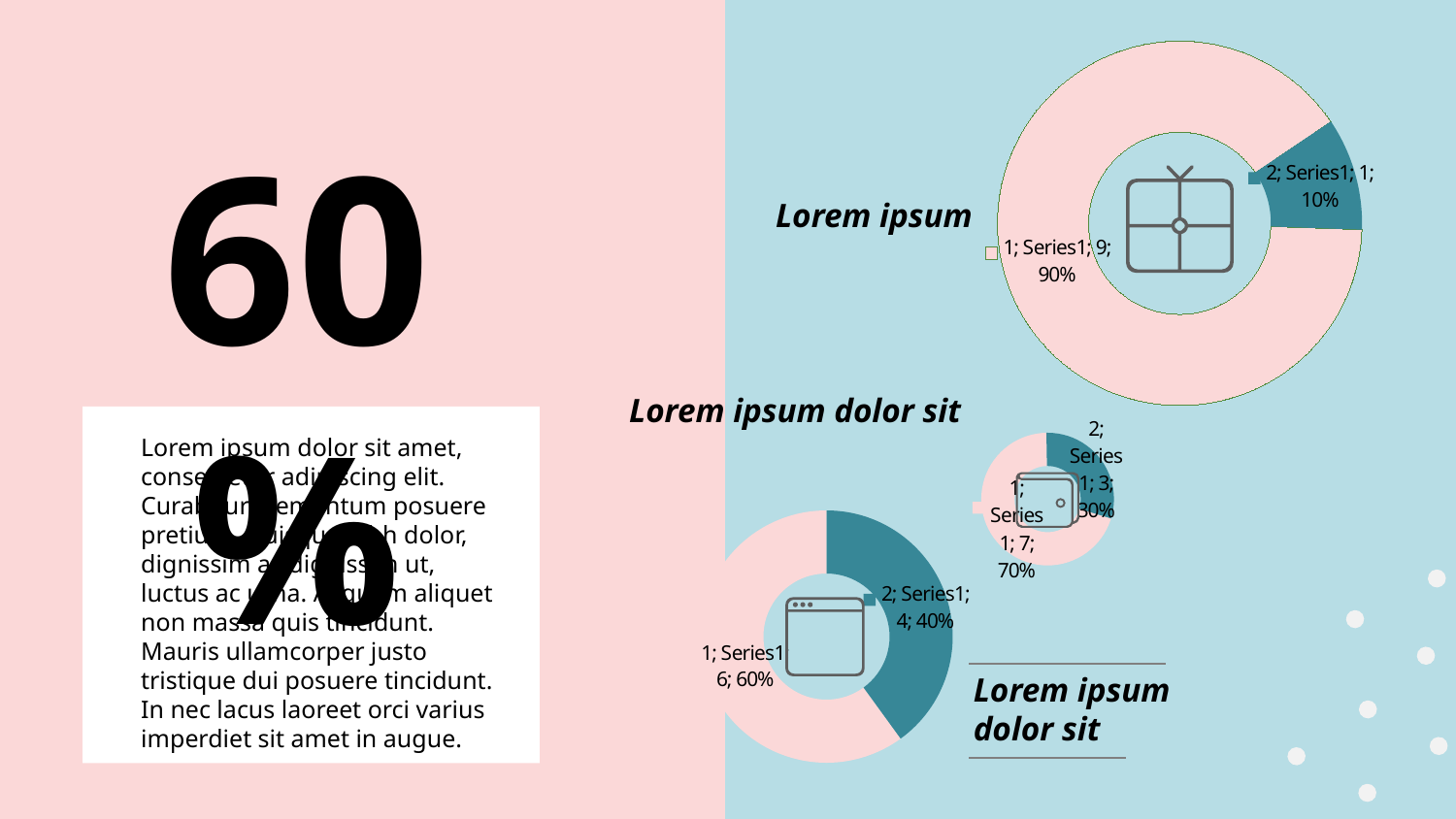
In the top-right doughnut chart, which category has the larger share? 1 In the small doughnut chart in the middle of the slide, what percentage does category 2 represent? 30% In the top-right doughnut chart, what percentage does category 1 represent? 90% In the bottom-left doughnut chart, what is the value for category 2? 4 How many slices does the bottom-left doughnut chart have? 2 In the bottom-left doughnut chart, is the value for category 1 larger or smaller than the value for category 2? larger In the small doughnut chart in the middle of the slide, which category has the smaller share? 2 In the bottom-left doughnut chart, what percentage does category 1 represent? 60% In the small doughnut chart in the middle of the slide, what is the value for category 1? 7 What type of chart is shown in the top-right of the slide? doughnut chart In the top-right doughnut chart, what is the value for category 2? 1 In the top-right doughnut chart, what is the difference between the values of category 1 and category 2? 8